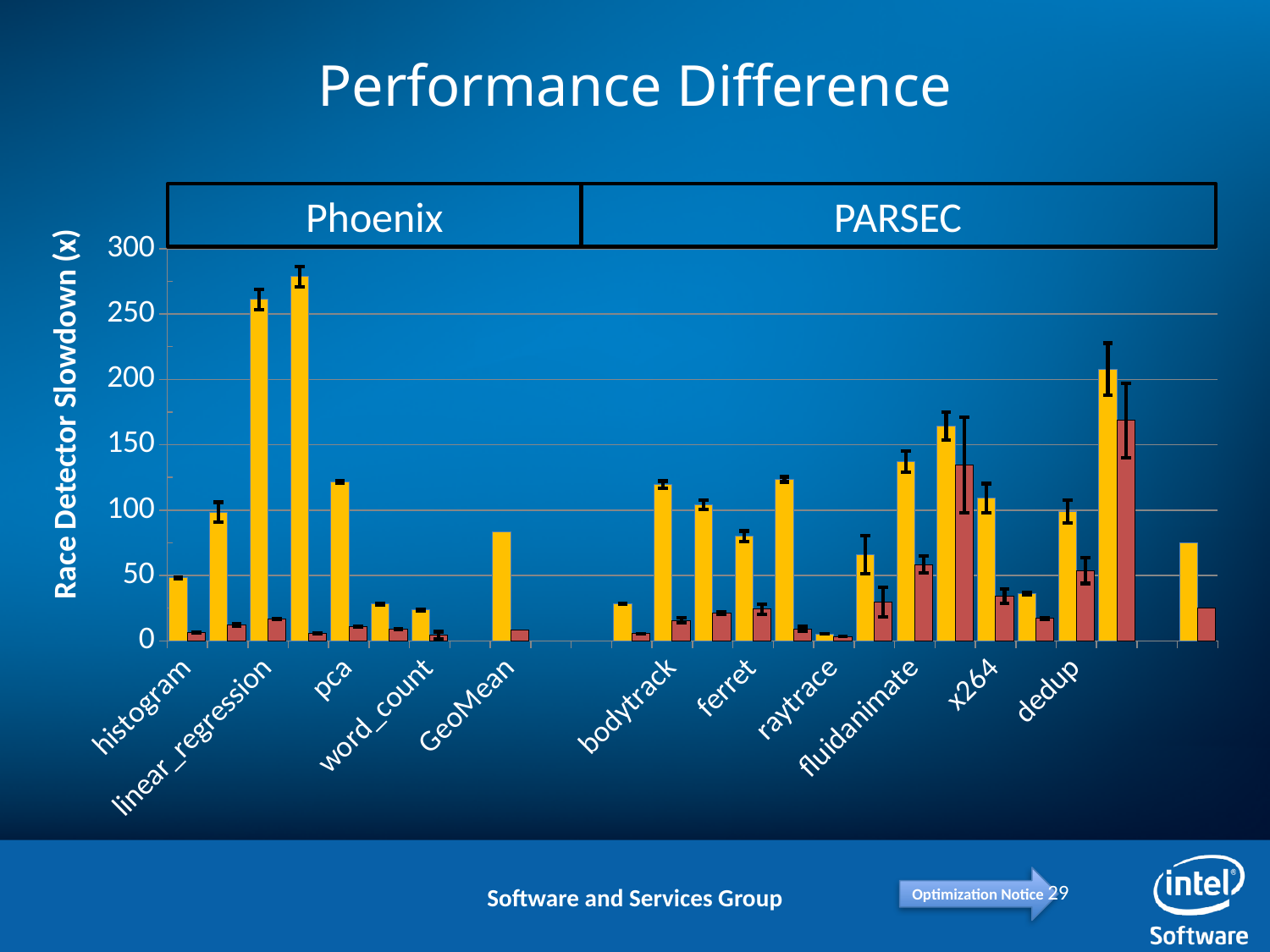
Is the yellow bar for histogram greater or less than 100? less What is the title of the chart? Performance Difference Is the yellow bar for fluidanimate greater or less than 100? greater Which is larger, the yellow bar for linear_regression or the yellow bar for histogram? linear_regression Which is larger, the yellow bar for fluidanimate or the yellow bar for raytrace? fluidanimate What kind of chart is shown on the slide? bar chart Is the yellow bar for GeoMean in the Phoenix group greater or less than 100? less What is the label on the vertical axis of the chart? Race Detector Slowdown (x)